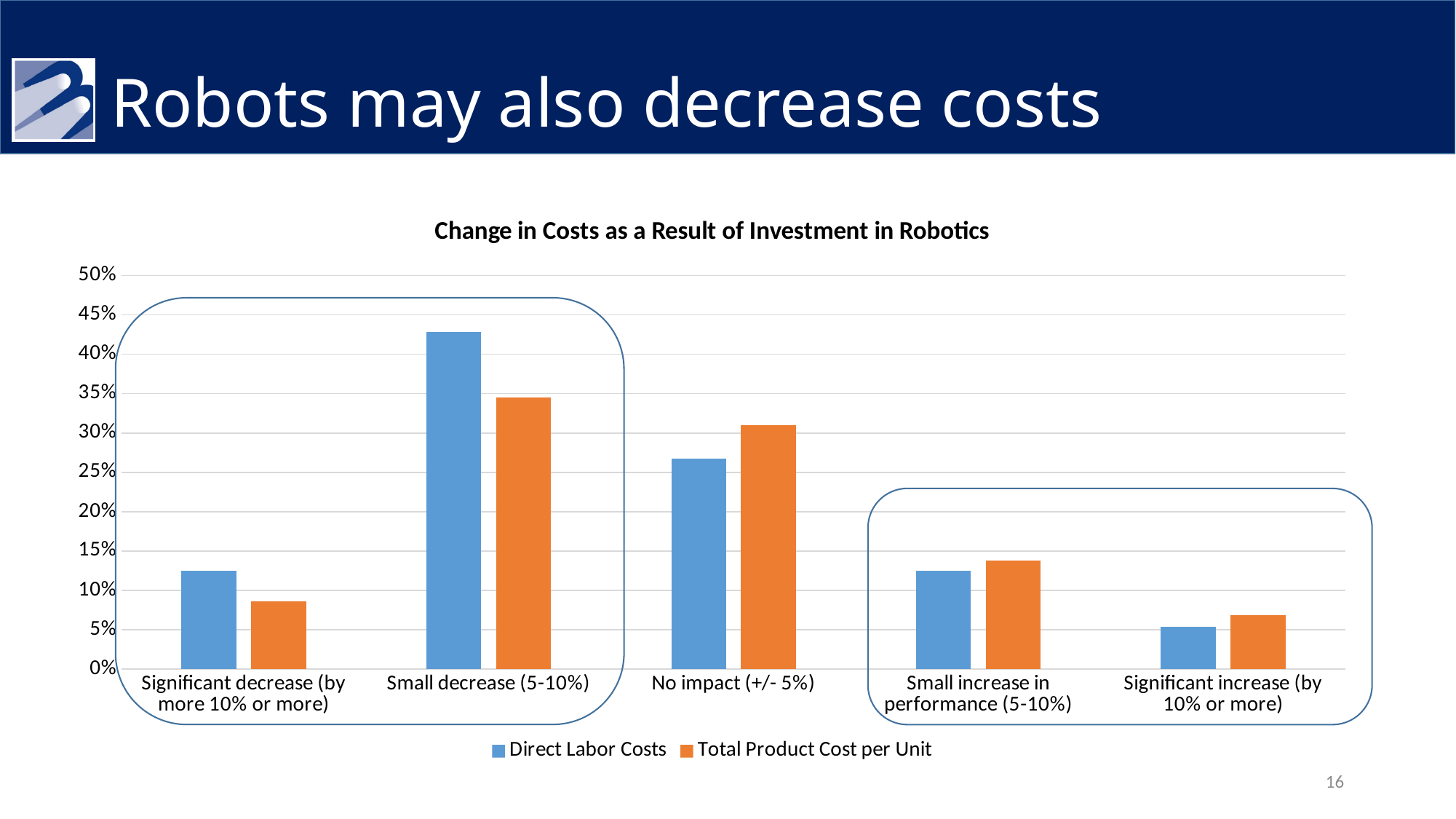
Which category has the highest value for Total Product Cost per Unit? Small decrease (5-10%) Which category has the highest value for Direct Labor Costs? Small decrease (5-10%) Which category has the lowest value for Direct Labor Costs? Significant increase (by 10% or more) How many categories are shown on the x axis? 5 What is the title of the chart? Change in Costs as a Result of Investment in Robotics How many series does the legend list? 2 Is the Direct Labor Costs value for Significant increase (by 10% or more) greater or less than 10%? less What type of chart is shown on the slide? bar chart Is the Total Product Cost per Unit value for Small decrease (5-10%) greater or less than 30%? greater Is the Direct Labor Costs value for Small decrease (5-10%) greater or less than 40%? greater For No impact (+/- 5%), which series has the larger value: Direct Labor Costs or Total Product Cost per Unit? Total Product Cost per Unit For Small decrease (5-10%), which series has the larger value: Direct Labor Costs or Total Product Cost per Unit? Direct Labor Costs